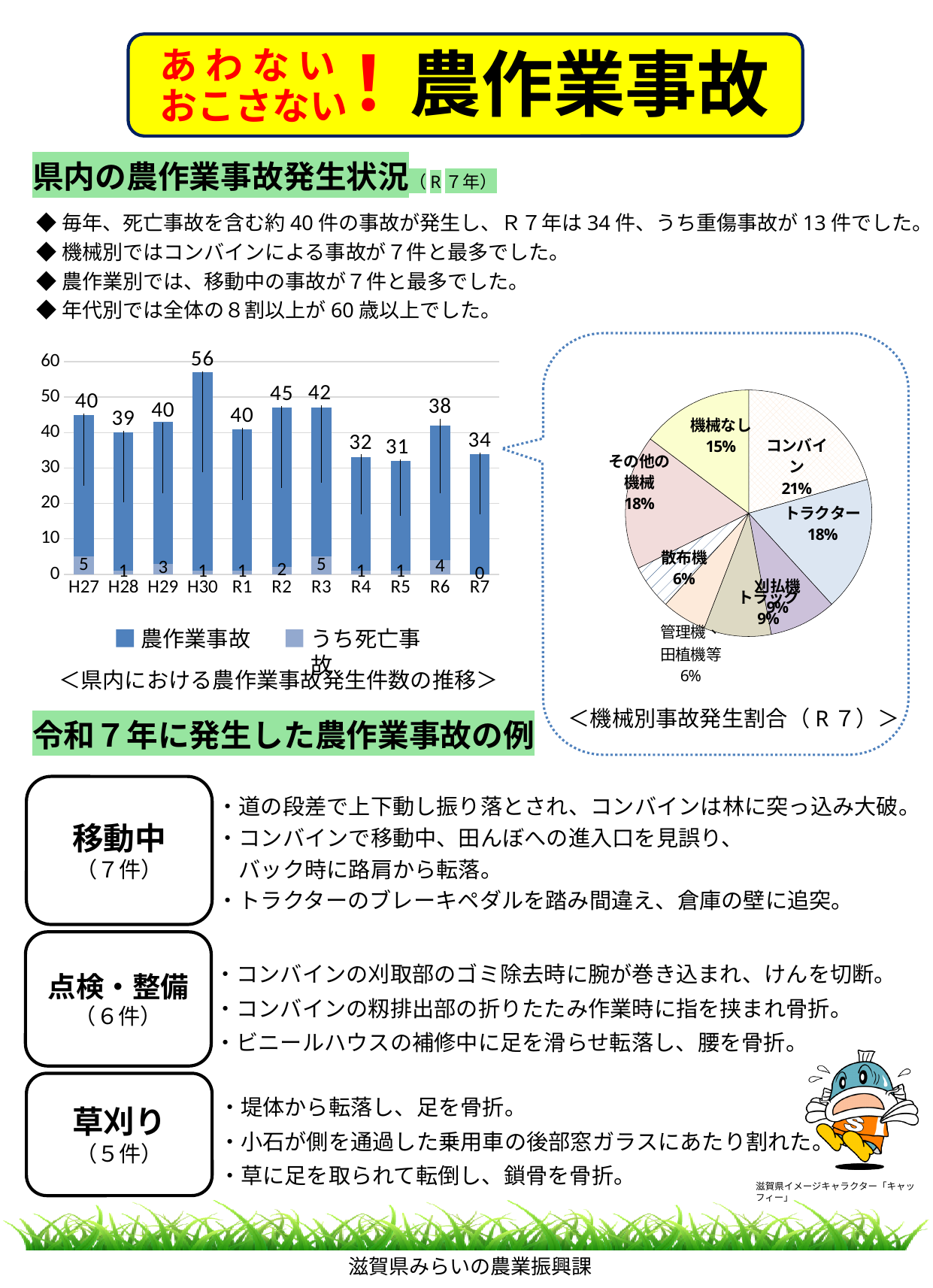
In the bar chart titled 県内における農作業事故発生件数の推移, which is larger, the 農作業事故 value for R2 or for R3? R2 In the pie chart titled 機械別事故発生割合（Ｒ７）, which category has the largest share? コンバイン What kind of chart is the chart titled 機械別事故発生割合（Ｒ７）? pie chart In the bar chart titled 県内における農作業事故発生件数の推移, what is the value of 農作業事故 for H30? 56 In the bar chart titled 県内における農作業事故発生件数の推移, what is the difference between the 農作業事故 values for H30 and R7? 22 In the bar chart titled 県内における農作業事故発生件数の推移, what is the total of the stacked bar for R6 (農作業事故 plus うち死亡事故)? 42 In the bar chart titled 県内における農作業事故発生件数の推移, which year has the highest value for 農作業事故? H30 In the bar chart titled 県内における農作業事故発生件数の推移, which year has the lowest value for 農作業事故? R5 In the bar chart titled 県内における農作業事故発生件数の推移, what is the value of うち死亡事故 for R7? 0 In the bar chart titled 県内における農作業事故発生件数の推移, how many series does the legend list? 2 In the bar chart titled 県内における農作業事故発生件数の推移, how many years are shown on the x axis? 11 In the pie chart titled 機械別事故発生割合（Ｒ７）, what share does コンバイン have? 21%